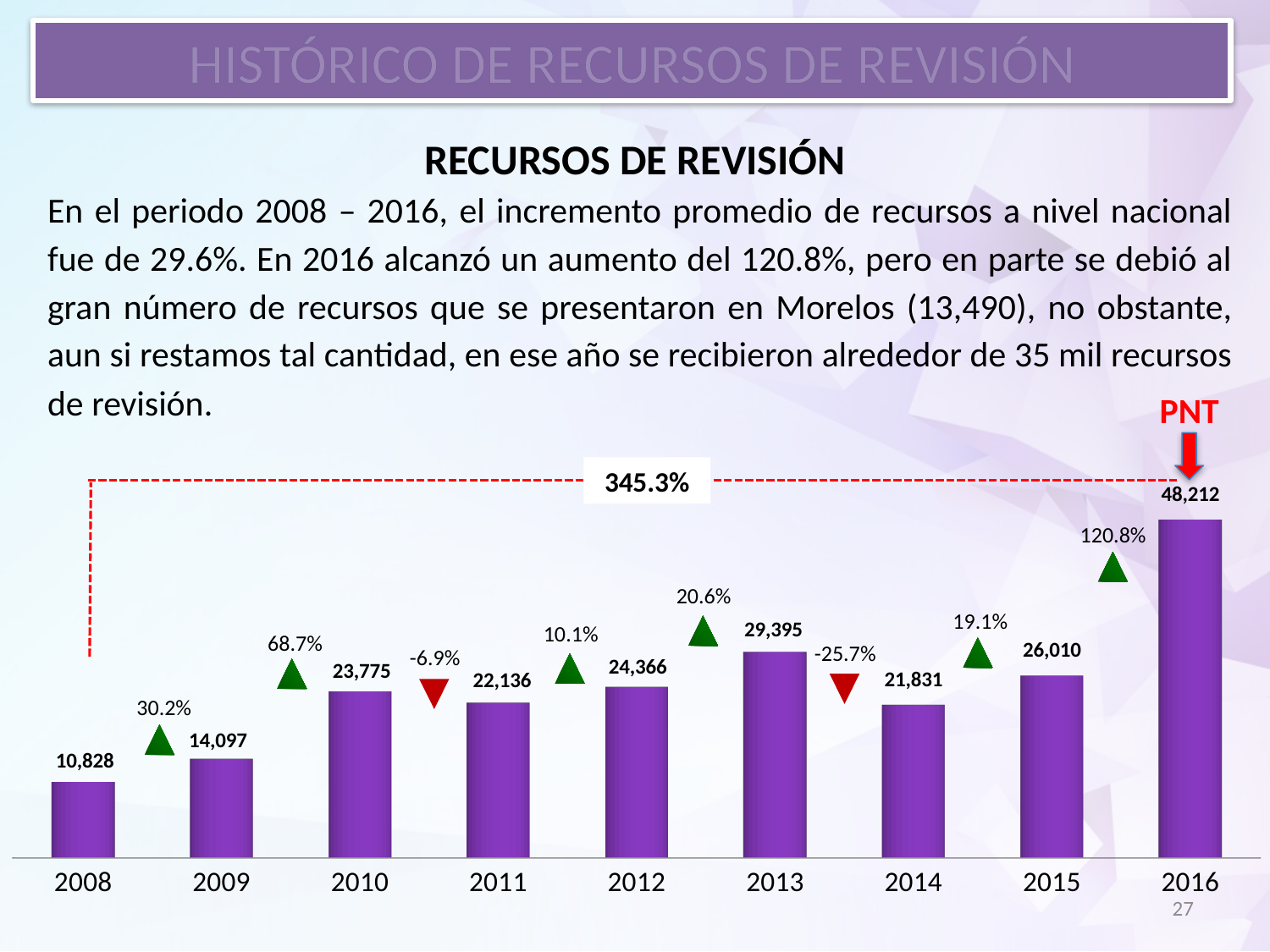
Which is larger, the value for 2011 or the value for 2012? 2012 What is the value for 2016? 48,212 What percentage is shown on the dashed red line spanning from 2008 to 2016? 345.3% Which year has the lowest value? 2008 What is the value for 2008? 10,828 What is the value for 2013? 29,395 Which year has the highest value? 2016 What percentage change is shown between 2015 and 2016? 120.8% How many years are shown on the x axis? 9 What is the difference between the values for 2013 and 2014? 7,564 What kind of chart is this? bar chart What is the difference between the values for 2016 and 2015? 22,202